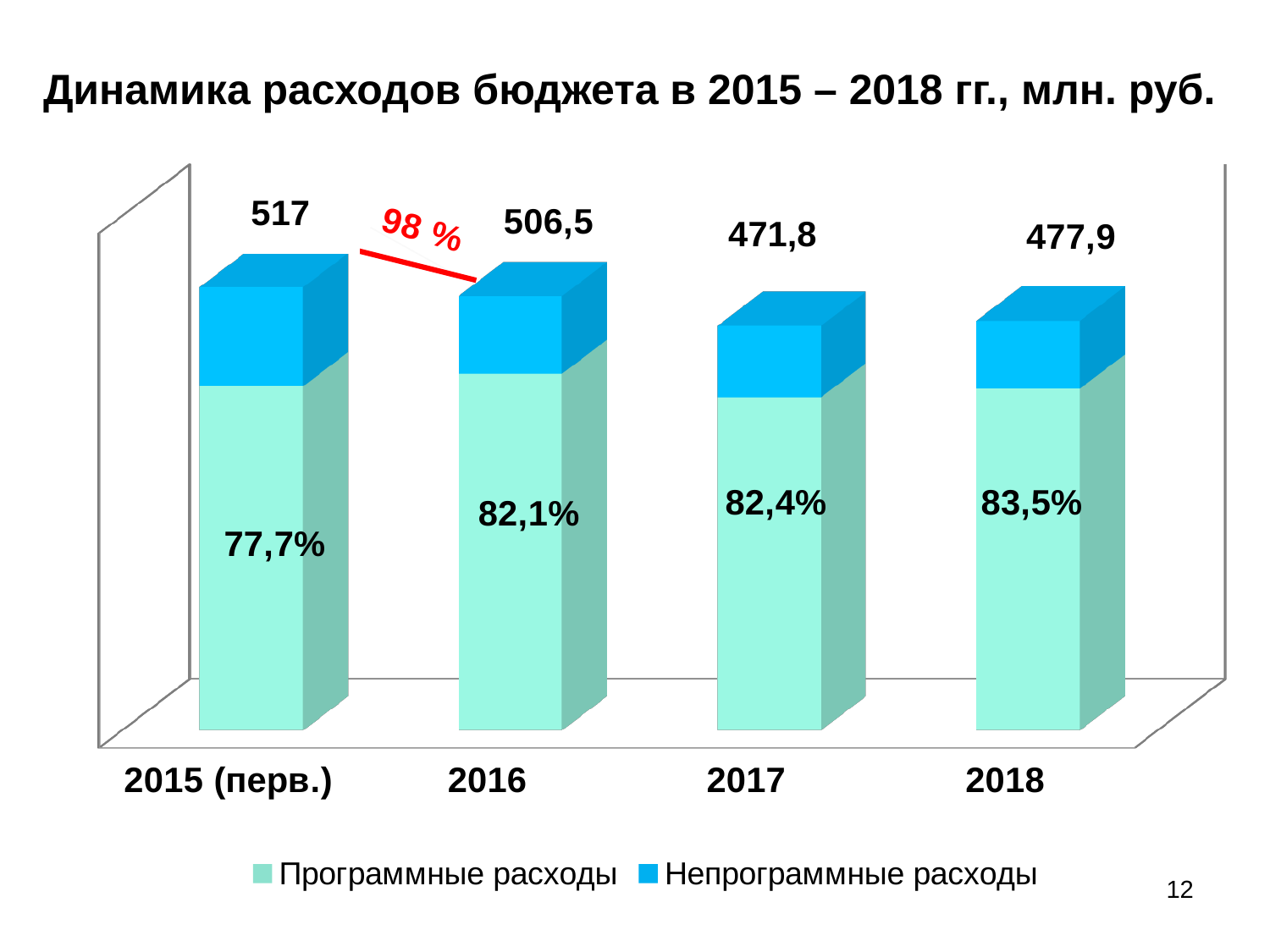
What kind of chart is shown on the slide? Stacked bar chart Which year has the highest total expenditure? 2015 (перв.) How many years (categories) are shown on the chart? 4 What is the difference between the total expenditure in 2015 (перв.) and in 2016? 10,5 What is the total value labelled above the bar for 2015 (перв.)? 517 How many series does the legend list? 2 What is the total budget expenditure shown for 2016? 506,5 What percentage is printed inside the Программные расходы segment for 2015 (перв.)? 77,7% What share of expenditure is labelled as Программные расходы in 2018? 83,5% Which is larger, the total expenditure in 2017 or in 2018? 2018 Which year has the lowest total expenditure? 2017 Does the share of Программные расходы rise or fall from 2015 (перв.) to 2018? Rises